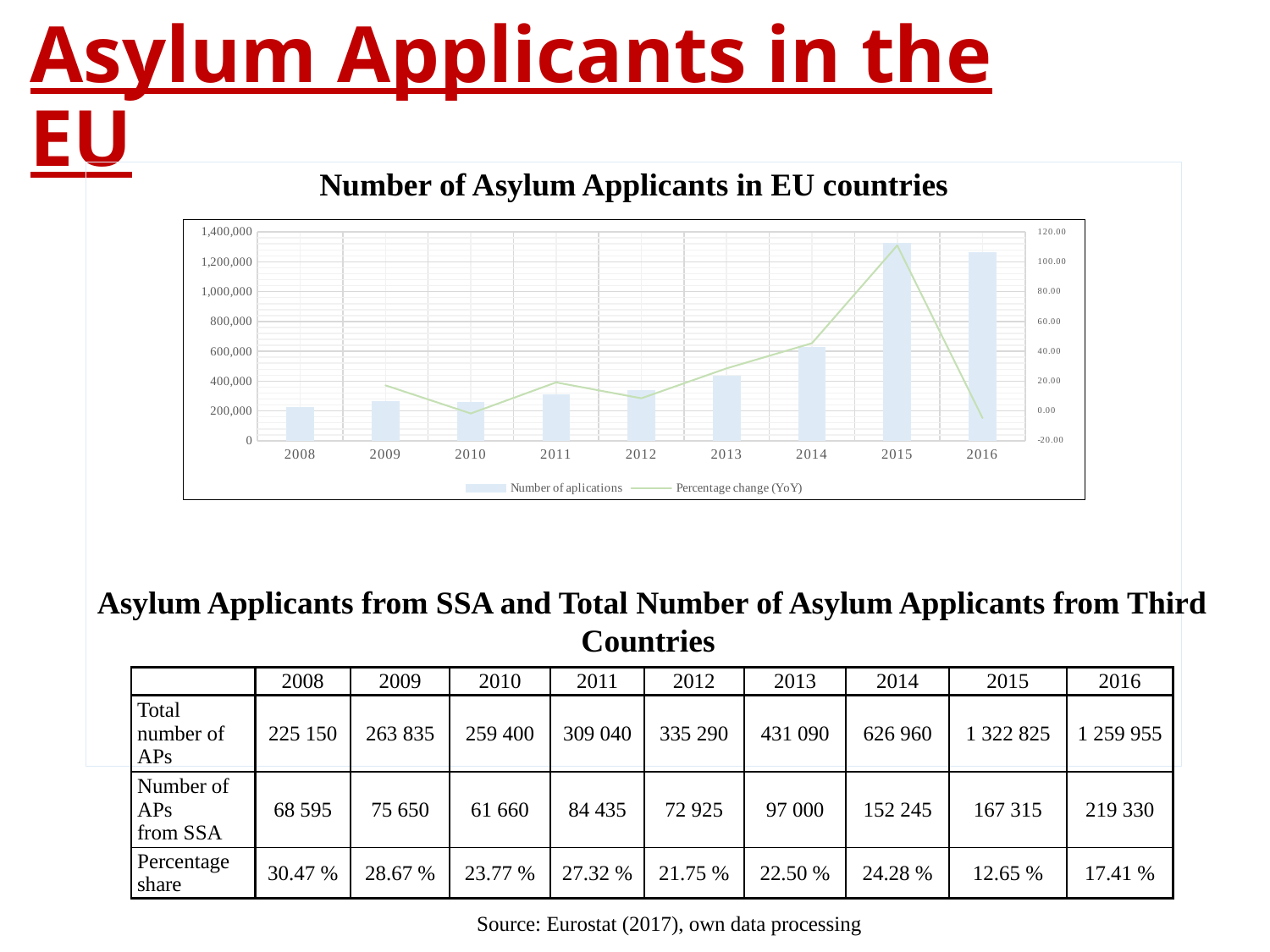
How many years are shown on the x axis of the chart? 9 Is the number of applications bar for 2008 greater or less than 400,000? less In which year is the bar for number of applications highest? 2015 In which year does the percentage change (YoY) line reach its peak? 2015 Which year has the larger number of applications bar, 2013 or 2014? 2014 How many series does the chart's legend list? 2 In which year is the bar for number of applications lowest? 2008 Do the number of applications bars generally rise or fall from 2008 to 2015? rise Is the number of applications bar for 2015 greater or less than 1,200,000? greater What are the two series named in the chart's legend? Number of aplications; Percentage change (YoY) What kind of chart is shown on the slide? A combined bar and line chart What is the title of the chart on the slide? Number of Asylum Applicants in EU countries